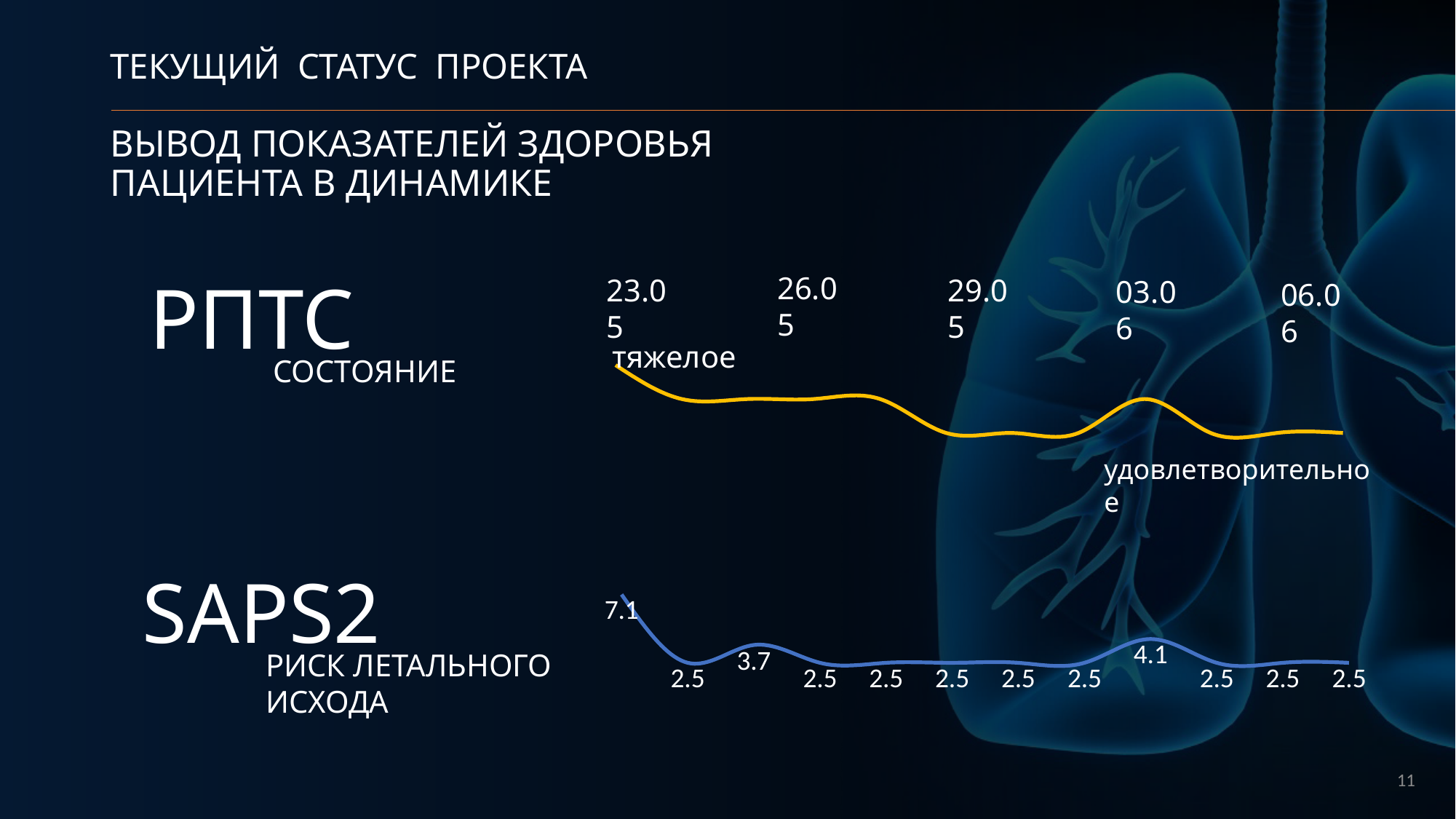
On the SAPS2 chart, what is the difference between the first value (7.1) and the lowest value (2.5)? 4.6 On the SAPS2 chart, what is the highest value shown? 7.1 On the SAPS2 chart, what is the value of the first data point? 7.1 On the РПТС chart, what label is shown at the start of the line and what label at the end? тяжелое; удовлетворительное What kind of chart is the SAPS2 chart on the slide? line chart On the SAPS2 chart, do the values overall rise or fall from left to right? fall On the SAPS2 chart, what is the lowest value shown? 2.5 On the РПТС chart, how many dates are shown along the top? 5 On the SAPS2 chart, how many data points are labelled? 12 What kind of chart is the РПТС chart on the slide? line chart On the SAPS2 chart, which is larger: the value 3.7 near the start or the value 4.1 near the end? 4.1 On the SAPS2 chart, what is the value of the third data point? 3.7